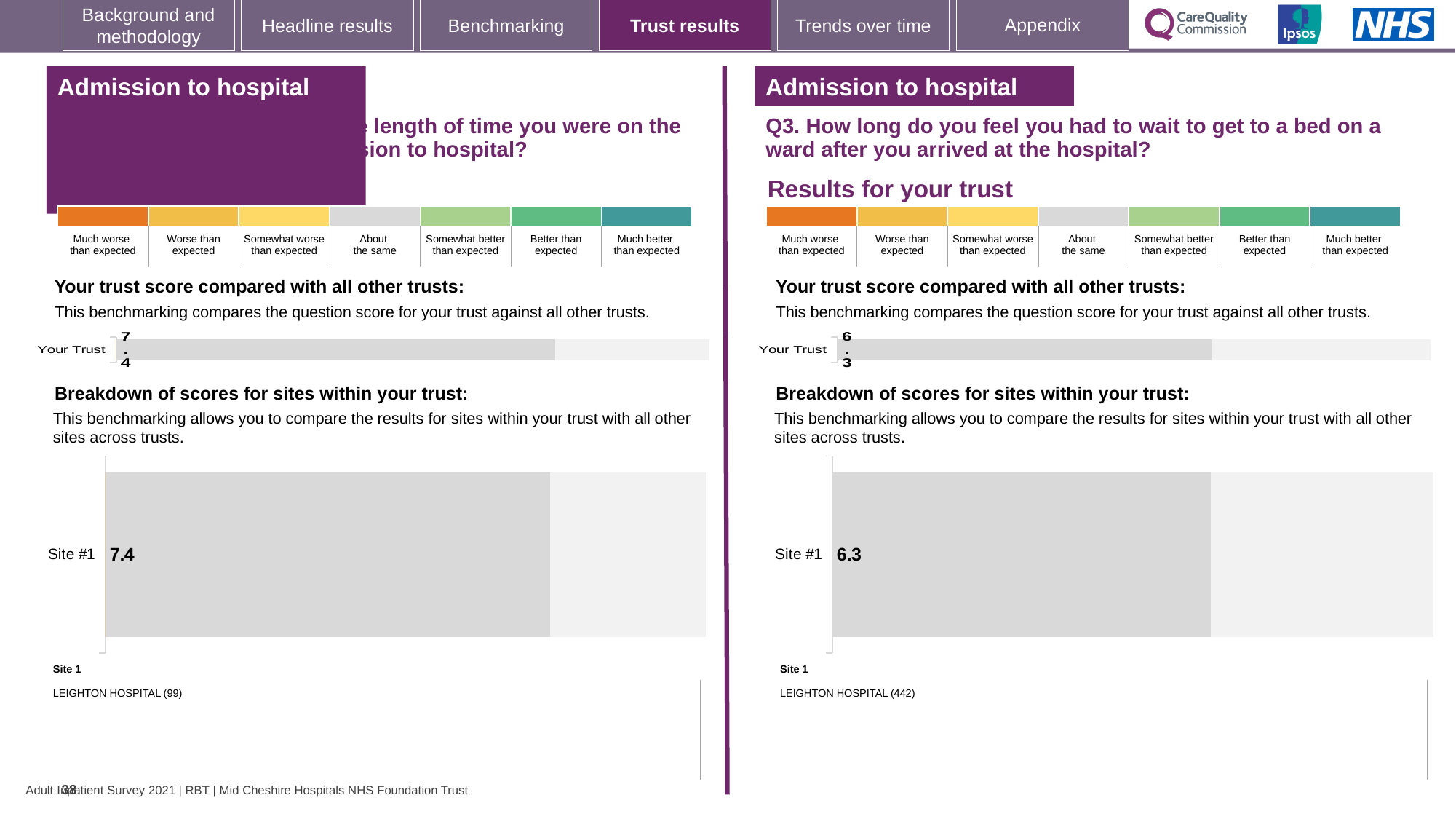
What kind of chart is used to show the Site #1 score on the right panel (Q3)? Bar chart On the left panel's 'Your trust score compared with all other trusts' chart, what is the score for Your Trust? 7.4 What is the difference between the Site #1 score on the left panel and the Site #1 score on the right panel (Q3)? 1.1 On the right panel (Q3) 'Your trust score compared with all other trusts' chart, what is the score for Your Trust? 6.3 Which hospital is listed as Site 1 on the right panel (Q3)? LEIGHTON HOSPITAL (442) How many sites are shown in the 'Breakdown of scores for sites within your trust' chart on the left panel? 1 On the right panel (Q3) 'Breakdown of scores for sites within your trust' chart, what is the score for Site #1? 6.3 Which is larger: the Your Trust score on the left panel or the Your Trust score on the right panel (Q3)? Left panel On the left panel's 'Breakdown of scores for sites within your trust' chart, what is the score for Site #1? 7.4 How many sites are shown in the 'Breakdown of scores for sites within your trust' chart on the right panel (Q3)? 1 Which hospital is listed as Site 1 on the left panel? LEIGHTON HOSPITAL (99)